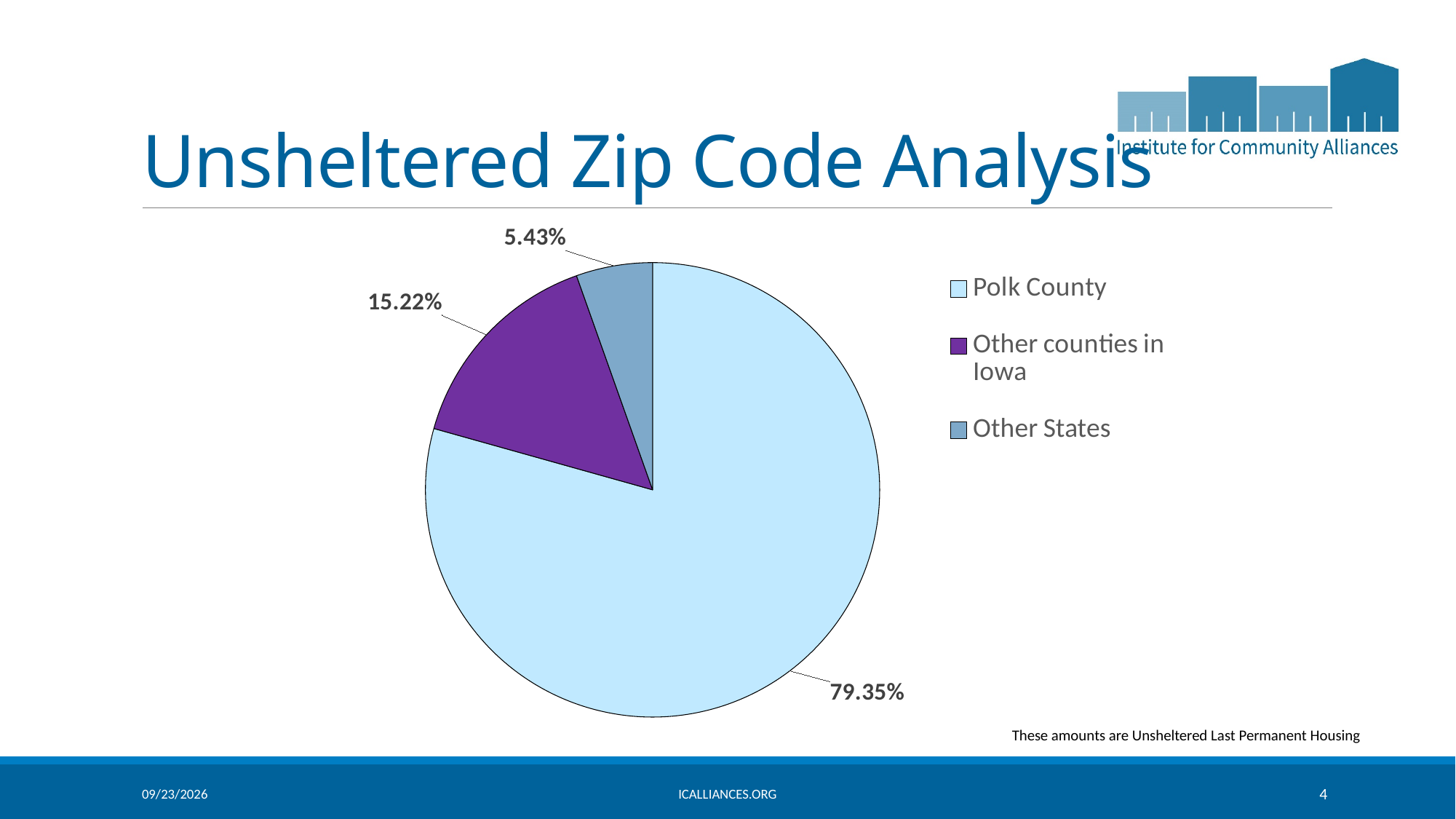
How many categories does the pie chart have? 3 What share of the pie does Other counties in Iowa represent? 15.22% Which category has the largest slice of the pie? Polk County What colour is the slice for Other counties in Iowa? purple What is the title of the slide containing the pie chart? Unsheltered Zip Code Analysis What is the difference between the Other counties in Iowa share and the Other States share? 9.79% Which category has the smallest slice of the pie? Other States What share of the pie does Polk County represent? 79.35% What is the difference between the Polk County share and the Other counties in Iowa share? 64.13% What type of chart is shown on the slide? pie chart Which is larger, the share for Other counties in Iowa or the share for Other States? Other counties in Iowa What share of the pie does Other States represent? 5.43%